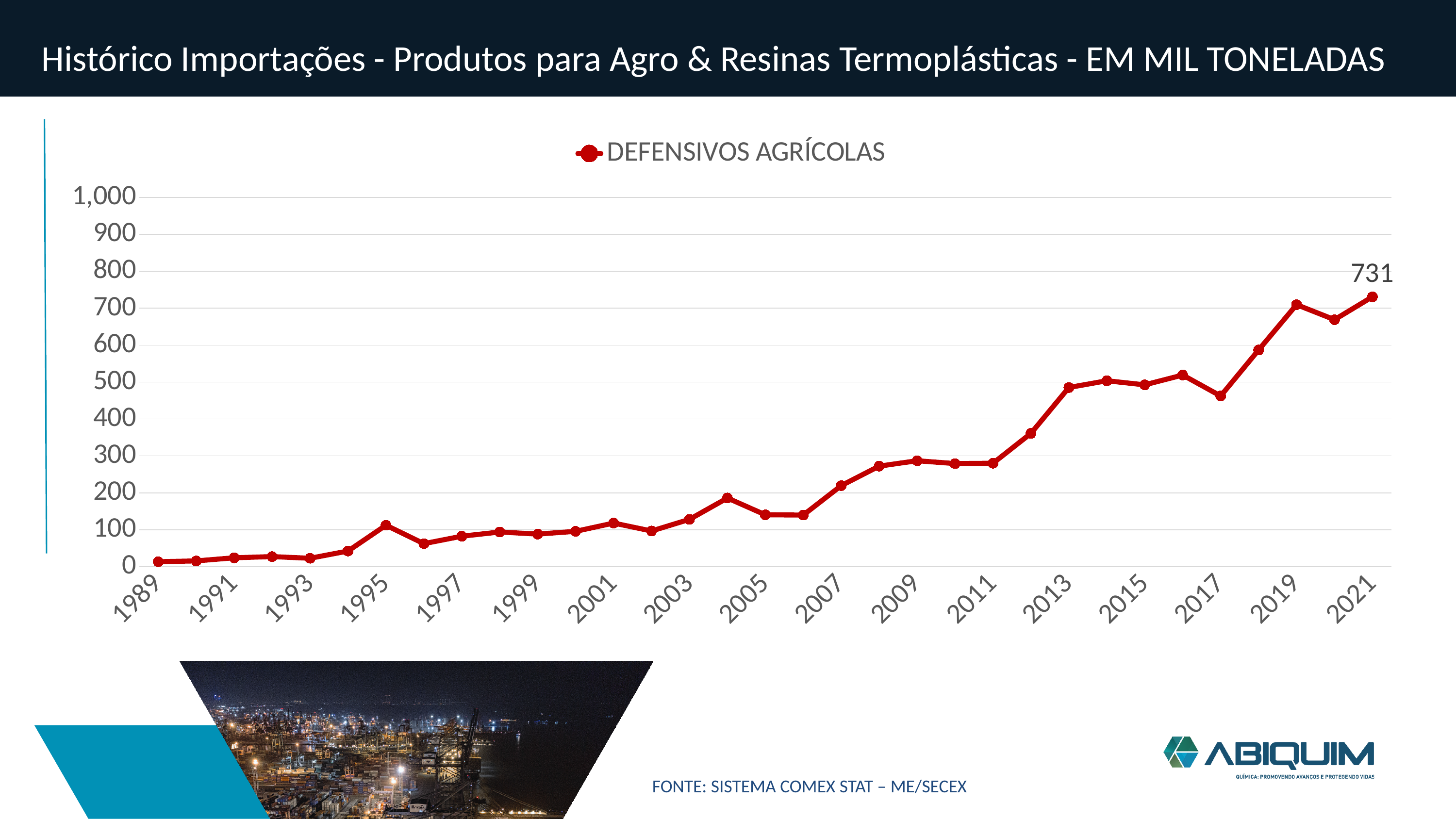
How many series does the legend list? 1 What is the value for 2021 in the DEFENSIVOS AGRÍCOLAS series? 731 How many data points are plotted on the line (years 1989 through 2021)? 33 Is the value for 2005 greater or less than 200? less What kind of chart is shown on the slide? line chart Which year has the larger value, 2013 or 2007? 2013 Which year has the highest value for DEFENSIVOS AGRÍCOLAS? 2021 Which year has the larger value, 2019 or 2020? 2019 Do the values generally rise or fall from 1989 to 2021? rise Is the value for 2017 greater or less than 500? less Is the value for 2019 greater or less than 600? greater